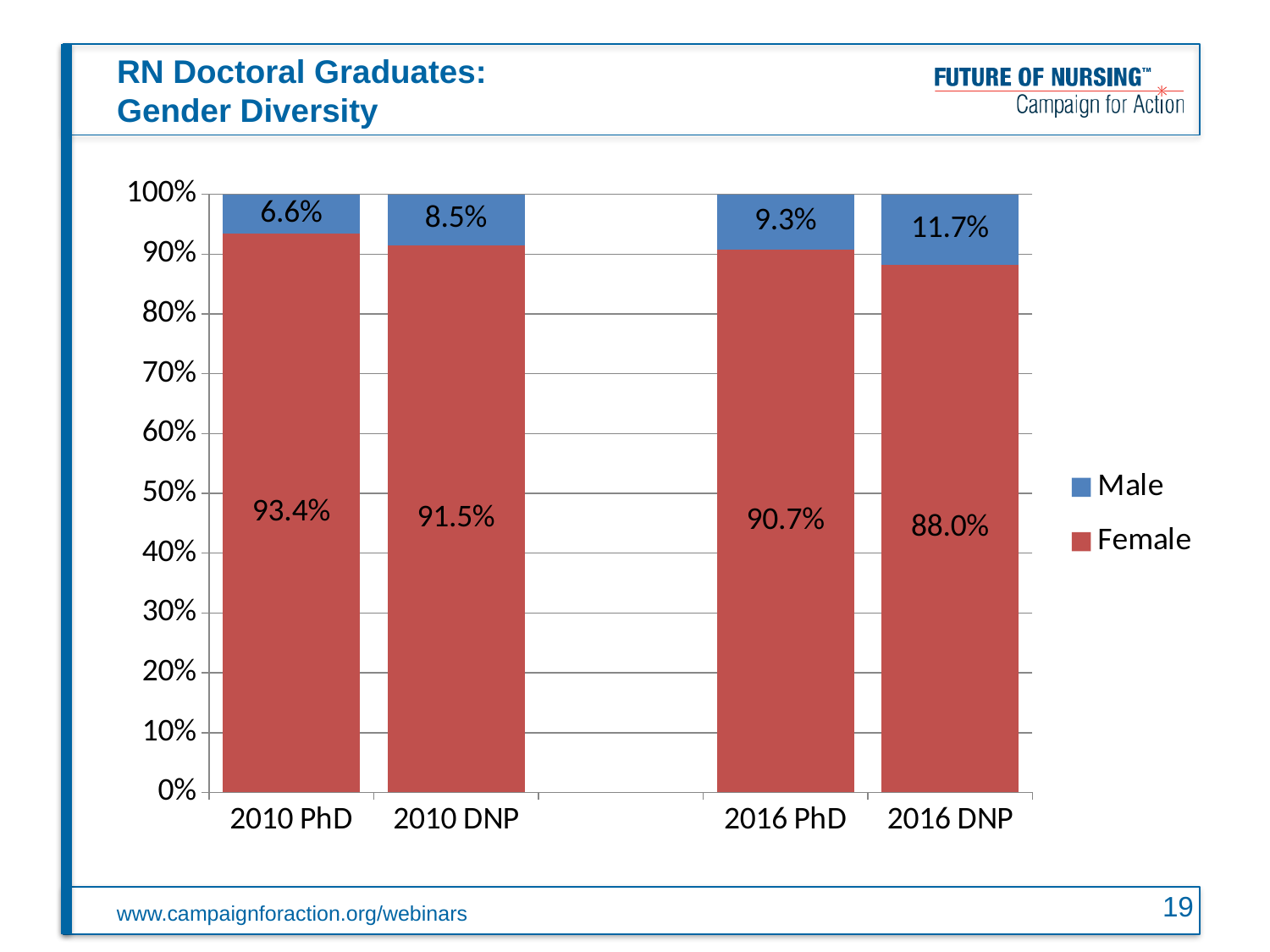
What is the Female value for 2010 PhD? 93.4% Which is larger, the Female value for 2010 DNP or for 2016 PhD? 2010 DNP What is the Female value for 2016 PhD? 90.7% What is the Male value for 2010 DNP? 8.5% Which category has the highest Male value? 2016 DNP How many categories are shown on the x axis? 4 What kind of chart is shown on the slide? Stacked bar chart How many series does the legend list? 2 What is the difference between the Male values for 2016 DNP and 2010 PhD? 5.1% Does the Male share rise or fall from 2010 PhD to 2016 DNP? Rise What is the Male value for 2016 DNP? 11.7% Which category has the lowest Female value? 2016 DNP